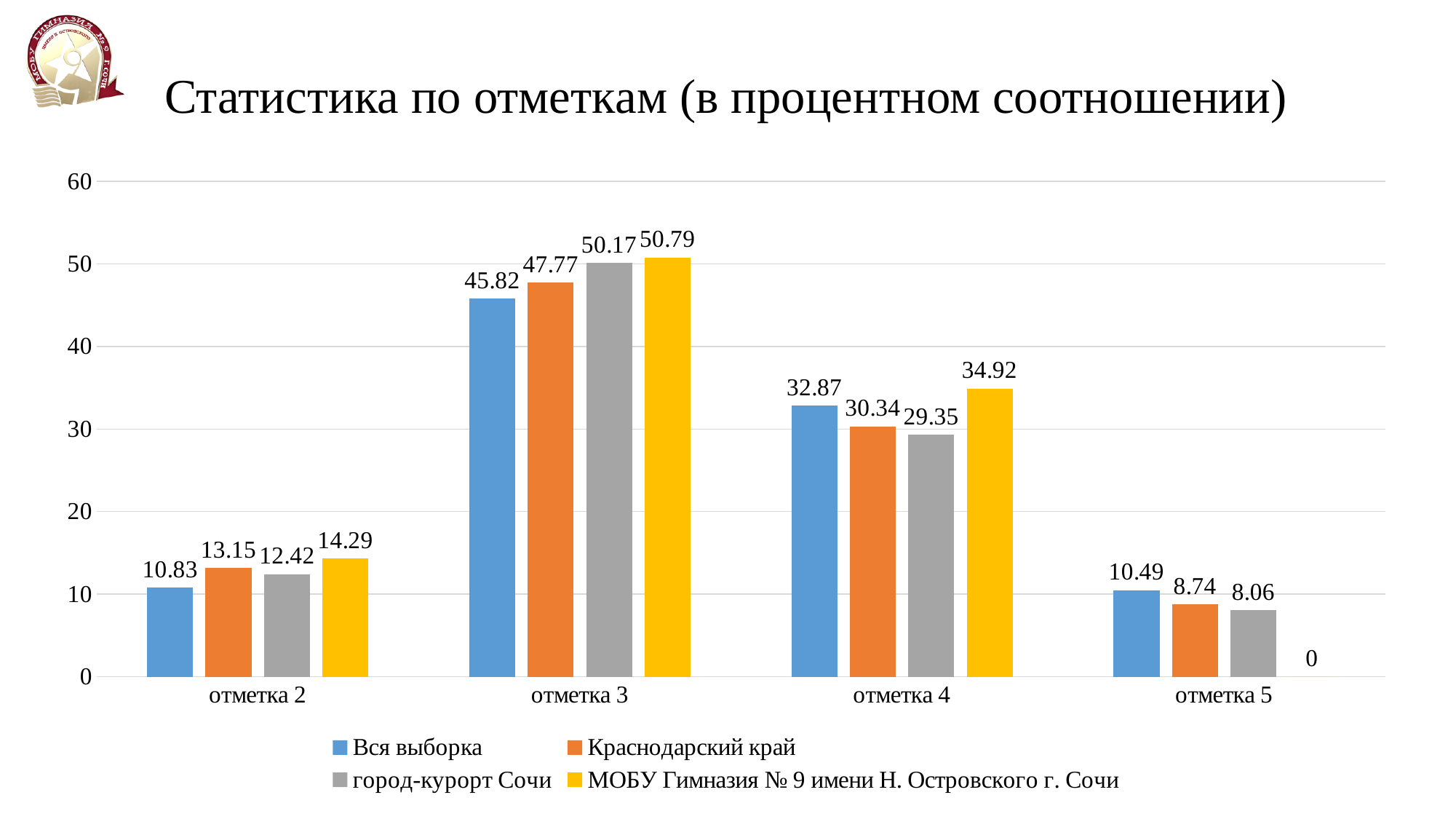
Which series has the lowest value at отметка 5? МОБУ Гимназия № 9 имени Н. Островского г. Сочи What is the value for город-курорт Сочи at отметка 5? 8.06 What is the value for Краснодарский край at отметка 2? 13.15 Which series has the highest value at отметка 3? МОБУ Гимназия № 9 имени Н. Островского г. Сочи How many categories are shown on the x axis? 4 What is the value for МОБУ Гимназия № 9 имени Н. Островского г. Сочи at отметка 4? 34.92 How many series does the legend list? 4 What is the difference between the МОБУ Гимназия № 9 value and the город-курорт Сочи value at отметка 4? 5.57 What is the difference between the МОБУ Гимназия № 9 value and the Вся выборка value at отметка 3? 4.97 What kind of chart is shown on the slide? Bar chart Which is larger at отметка 4: Вся выборка or Краснодарский край? Вся выборка What is the value for Вся выборка at отметка 3? 45.82